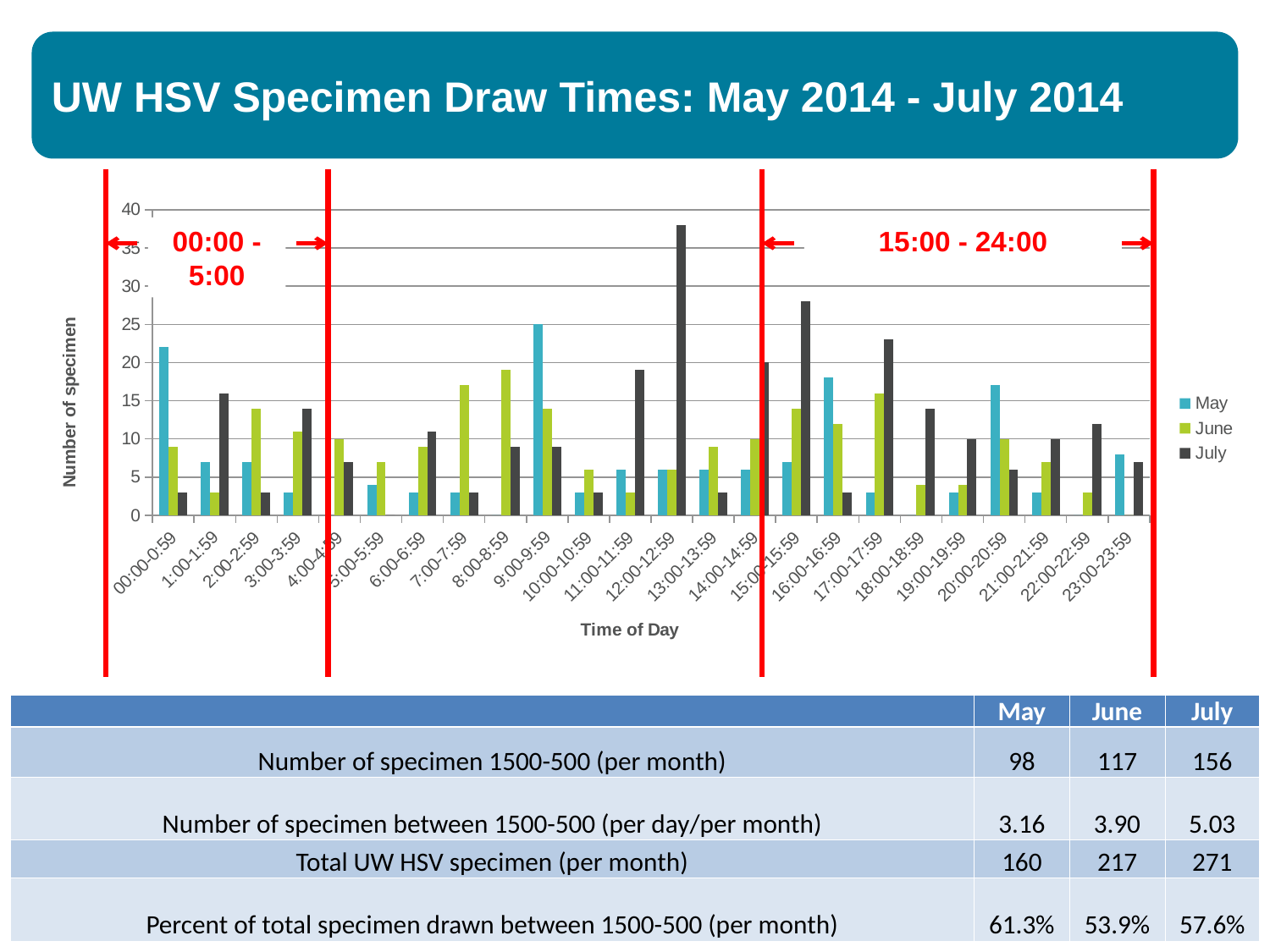
Is the July value for 15:00-15:59 greater or less than 25? greater Which time slot has the highest May bar? 9:00-9:59 Is the June value for 1:00-1:59 greater or less than 5? less For the 12:00-12:59 slot, which is larger: the May bar or the July bar? July Is the May value for 00:00-0:59 greater or less than 20? greater How many time-of-day categories are plotted along the x axis? 24 Which time slot has the highest July bar? 12:00-12:59 For the 00:00-0:59 slot, which is larger: the May bar or the July bar? May What type of chart is shown on the slide? bar chart What is the title of the chart's vertical axis? Number of specimen How many series does the chart legend list? 3